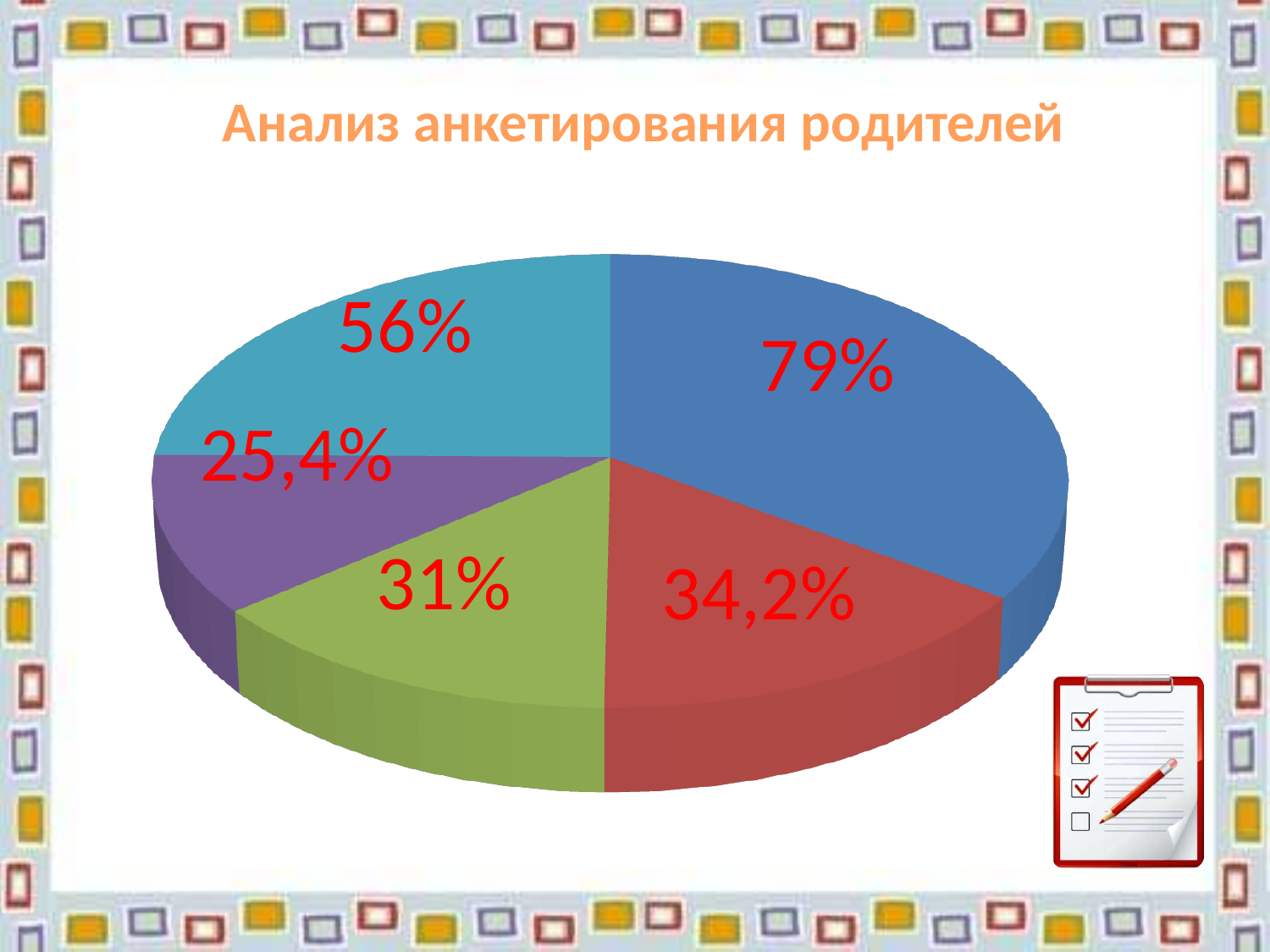
How many slices does the pie chart have? 5 What value is printed on the red slice of the pie chart? 34,2% What value is printed on the green slice of the pie chart? 31% What value is printed on the purple slice of the pie chart? 25,4% Which is larger, the value on the teal slice or the value on the red slice? the teal slice (56%) Which slice of the pie chart has the lowest printed value? the purple slice (25,4%) Which slice of the pie chart has the highest printed value? the blue slice (79%) What value is printed on the teal (light blue) slice of the pie chart? 56% What kind of chart is shown on the slide? pie chart What value is printed on the blue slice of the pie chart? 79% What is the title of the chart on the slide? Анализ анкетирования родителей What is the difference between the value on the blue slice and the value on the teal slice? 23%